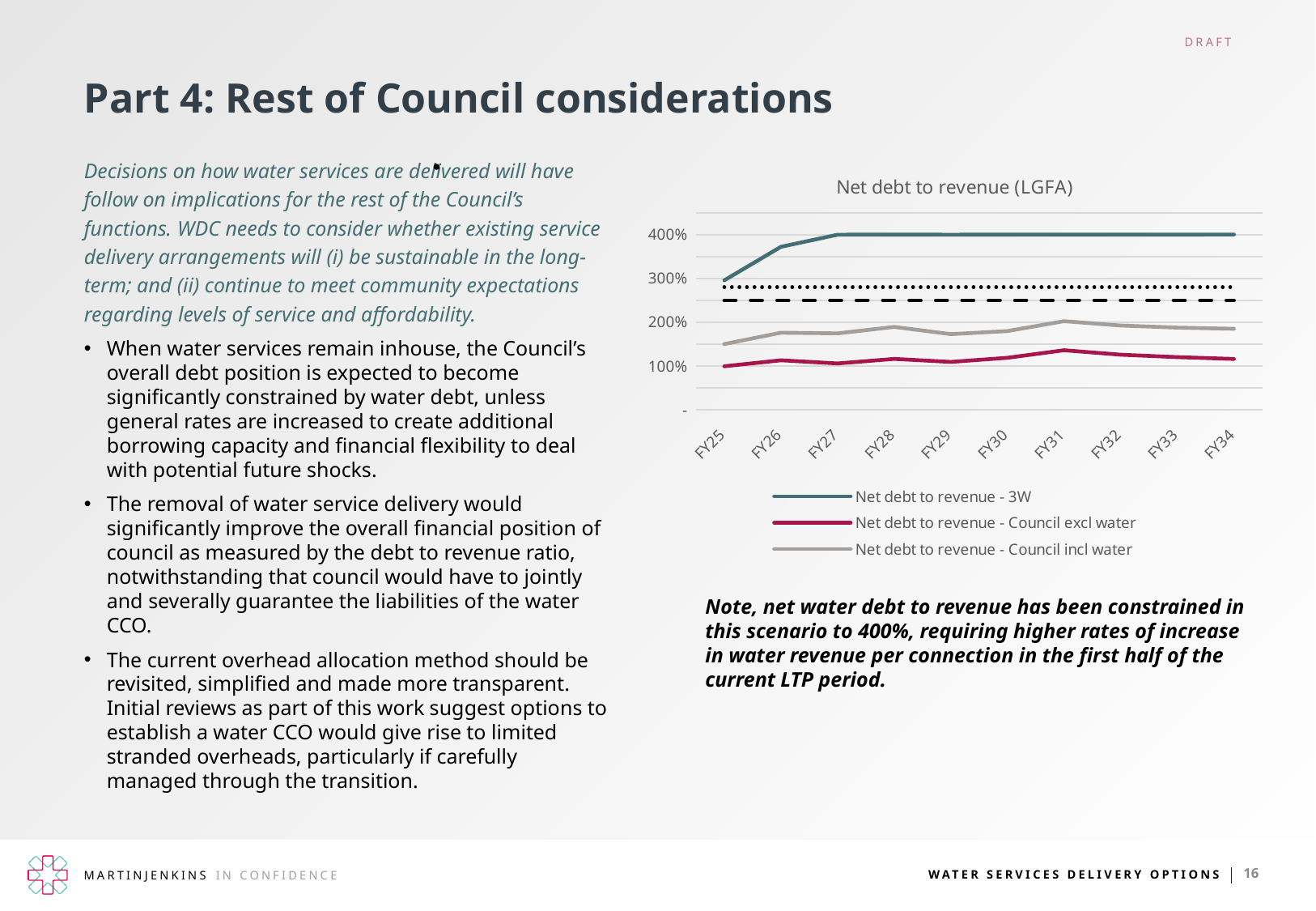
What is the title of the chart? Net debt to revenue (LGFA) Which series has the lowest values across the chart? Net debt to revenue - Council excl water How many series does the chart legend list? 3 What is the value of Net debt to revenue - 3W in FY30? 400% What kind of chart is shown on the slide? line chart Which series has the highest values across the chart? Net debt to revenue - 3W Is the value for Net debt to revenue - 3W in FY26 greater or less than 300%? greater How many financial years are shown on the x axis of the chart? 10 In FY30, which is larger: Net debt to revenue - 3W or Net debt to revenue - Council incl water? Net debt to revenue - 3W Does the Net debt to revenue - 3W line rise or fall from FY25 to FY27? rise Is the value for Net debt to revenue - Council incl water in FY25 greater or less than 200%? less Is the value for Net debt to revenue - Council excl water in FY31 greater or less than 100%? greater